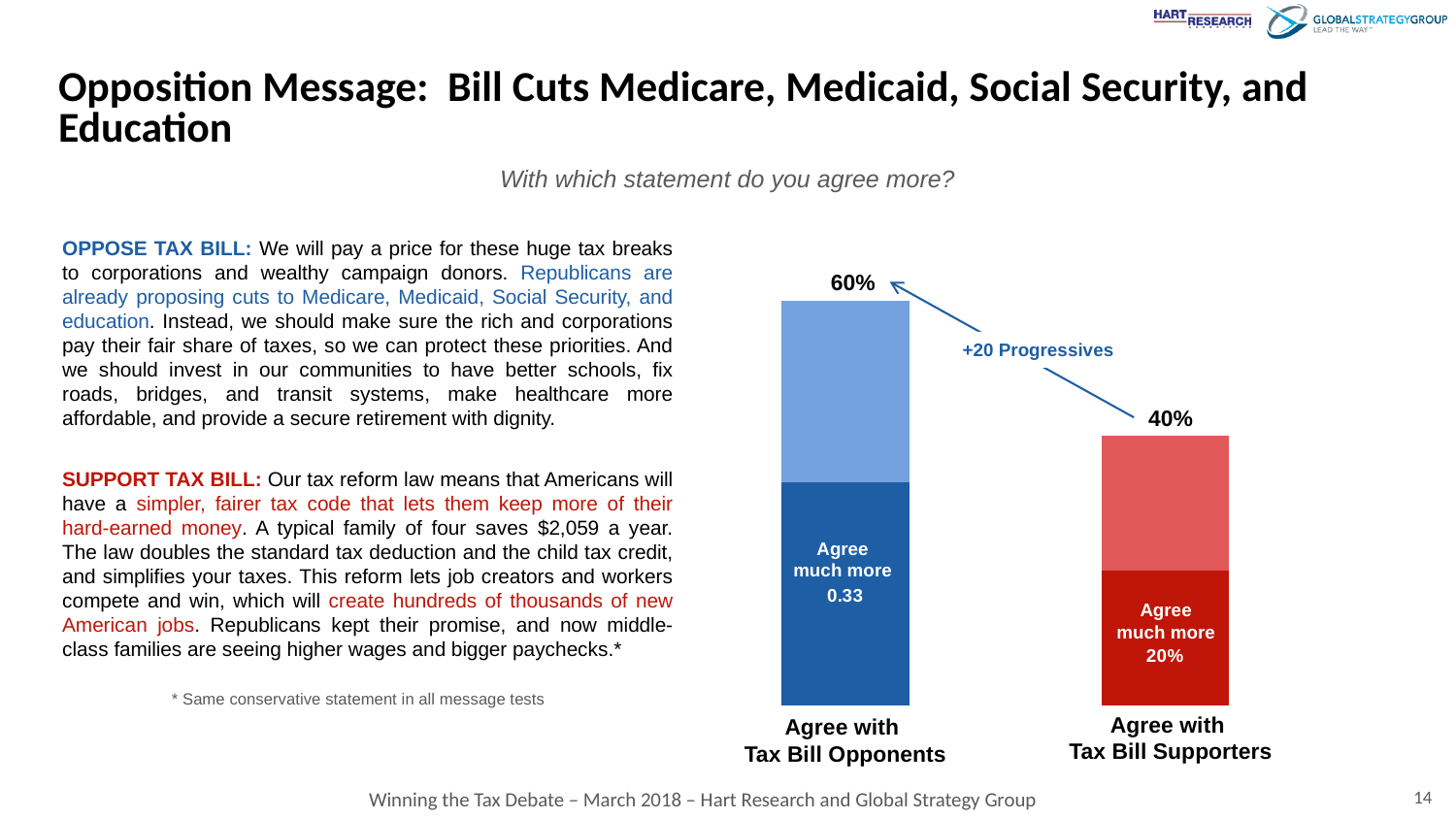
What annotation is written next to the arrow between the two bars? +20 Progressives Is the value for Agree with Tax Bill Supporters larger or smaller than the value for Agree with Tax Bill Opponents? smaller What is the 'Agree much more' value shown for Tax Bill Supporters? 20% Which bar is lower, Agree with Tax Bill Opponents or Agree with Tax Bill Supporters? Agree with Tax Bill Supporters What is the difference in percentage points between those who agree with Tax Bill Opponents and those who agree with Tax Bill Supporters? 20 How many bars are shown in the chart? 2 Do the bar totals rise or fall from left to right? fall What kind of chart is shown on the slide? stacked bar chart What is the 'Agree much more' value printed on the Tax Bill Opponents bar? 0.33 What percentage agree with Tax Bill Supporters? 40% Which bar is higher, Agree with Tax Bill Opponents or Agree with Tax Bill Supporters? Agree with Tax Bill Opponents What percentage agree with Tax Bill Opponents? 60%